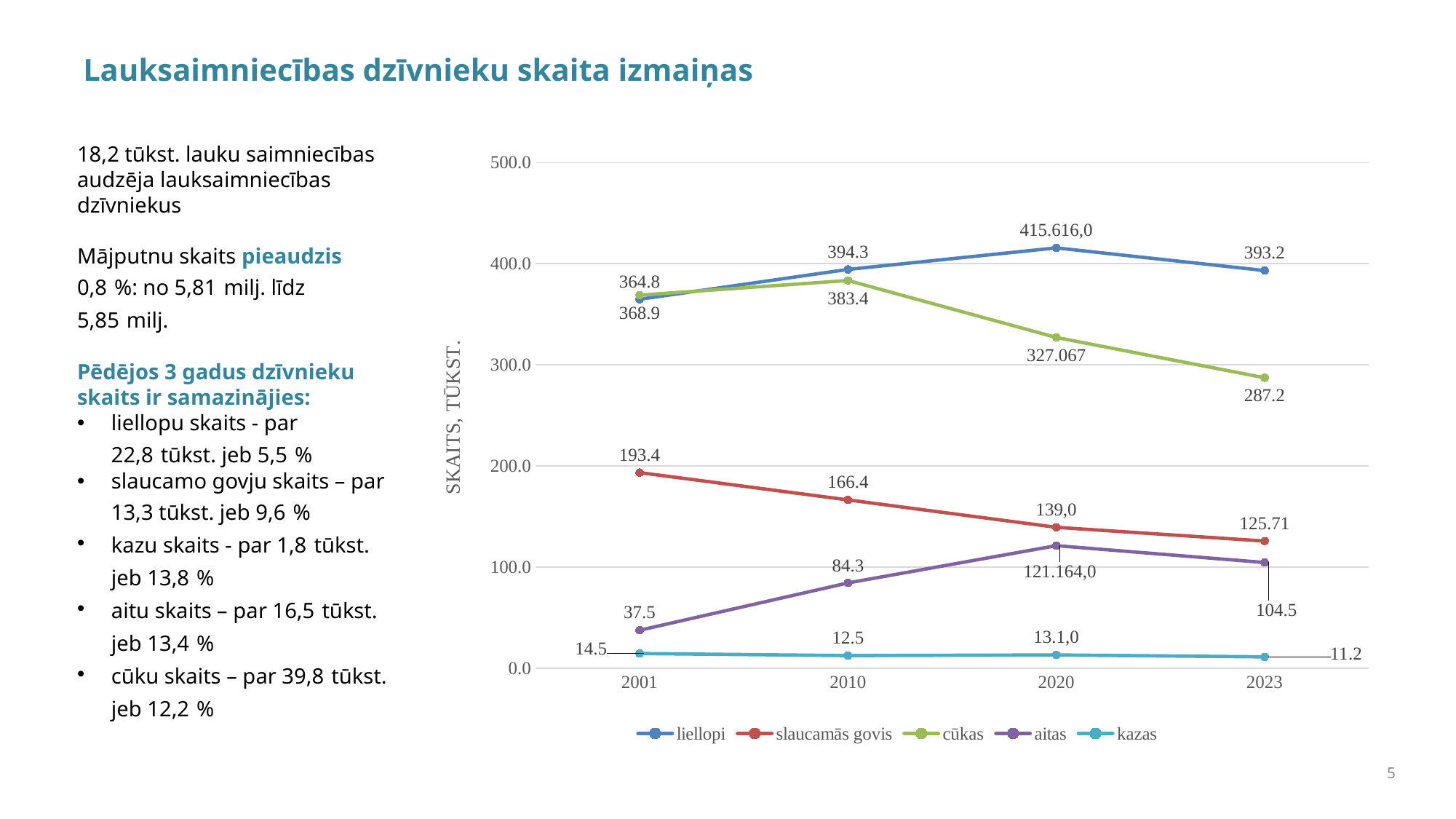
What is the value for slaucamās govis in 2001? 193.4 What is the value for cūkas in 2023? 287.2 What is the value for aitas in 2010? 84.3 Which is larger in 2001, the value for liellopi or the value for cūkas? cūkas Which series has the lowest value in 2001? kazas What is the value for kazas in 2001? 14.5 Does the value for slaucamās govis rise or fall from 2001 to 2023? fall Which series has the highest value in 2023? liellopi What is the value for liellopi in 2010? 394.3 How many years are shown on the x axis? 4 What is the difference between the cūkas values in 2010 and 2001? 14.5 How many series does the legend list? 5